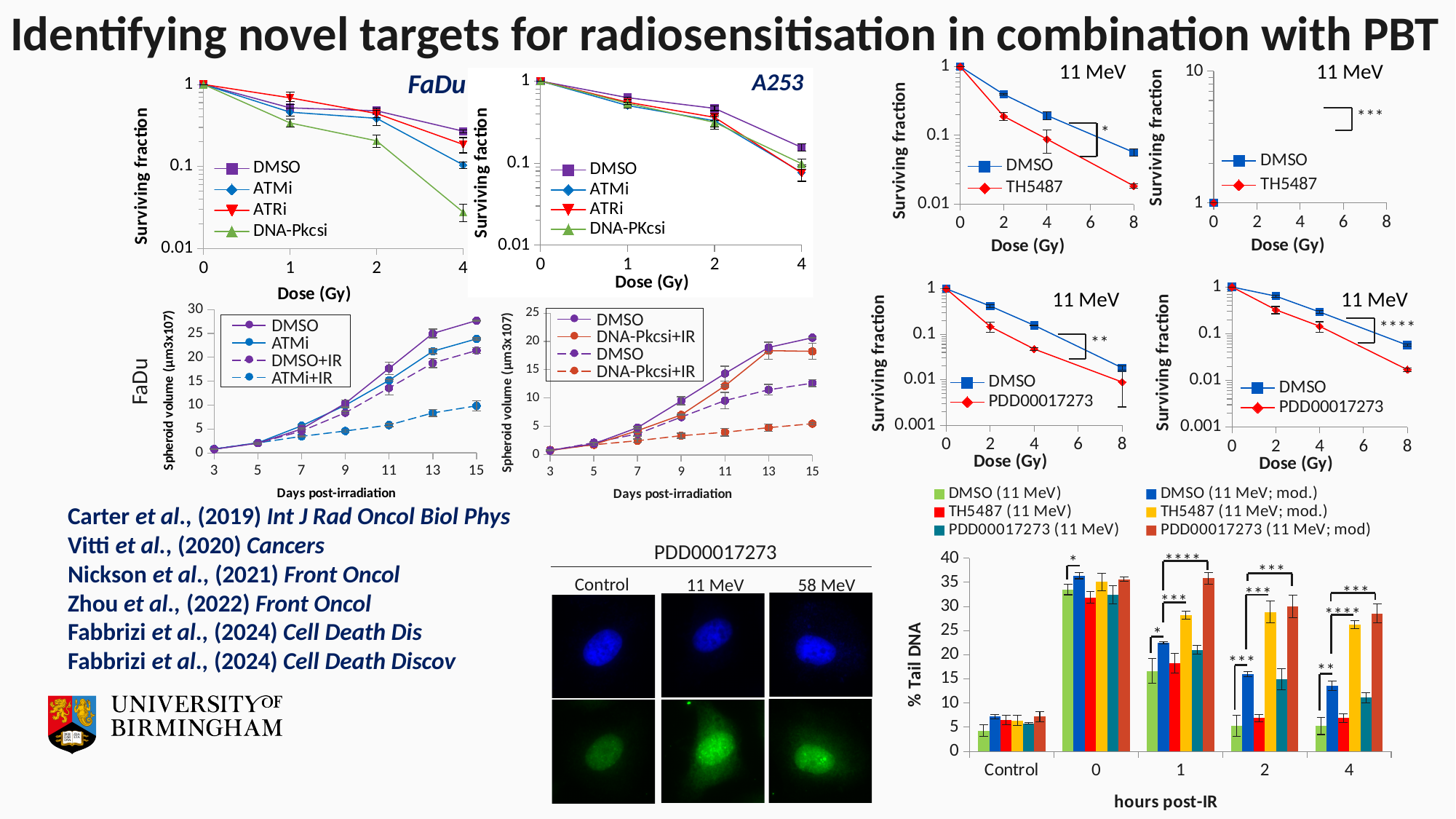
How many series does the legend of the top-left FaDu surviving fraction chart list? 4 What kind of chart is the bottom-right chart with the y-axis '% Tail DNA'? bar chart In the top-right 11 MeV surviving fraction chart comparing DMSO and TH5487, which series has the higher surviving fraction at 8 Gy? DMSO What is the x-axis label of the bottom-right '% Tail DNA' bar chart? hours post-IR In the FaDu spheroid volume chart, which series has the larger value at day 15: DMSO or ATMi+IR? DMSO How many categories are shown on the x-axis of the bottom-right '% Tail DNA' bar chart? 5 In the top-left FaDu surviving fraction chart, does the DNA-Pkcsi series rise or fall as dose increases? fall In the bottom-right '% Tail DNA' bar chart, is the value for DMSO (11 MeV; mod.) at 0 hours post-IR greater or less than 30? greater How many series does the legend of the bottom-right '% Tail DNA' bar chart list? 6 In the bottom-right '% Tail DNA' bar chart, is the value for PDD00017273 (11 MeV; mod) at 1 hour post-IR greater or less than 30? greater In the bottom-right '% Tail DNA' bar chart, is the value for DMSO (11 MeV) at Control greater or less than 10? less How many x-axis points (days post-irradiation) are shown on the FaDu spheroid volume chart? 7